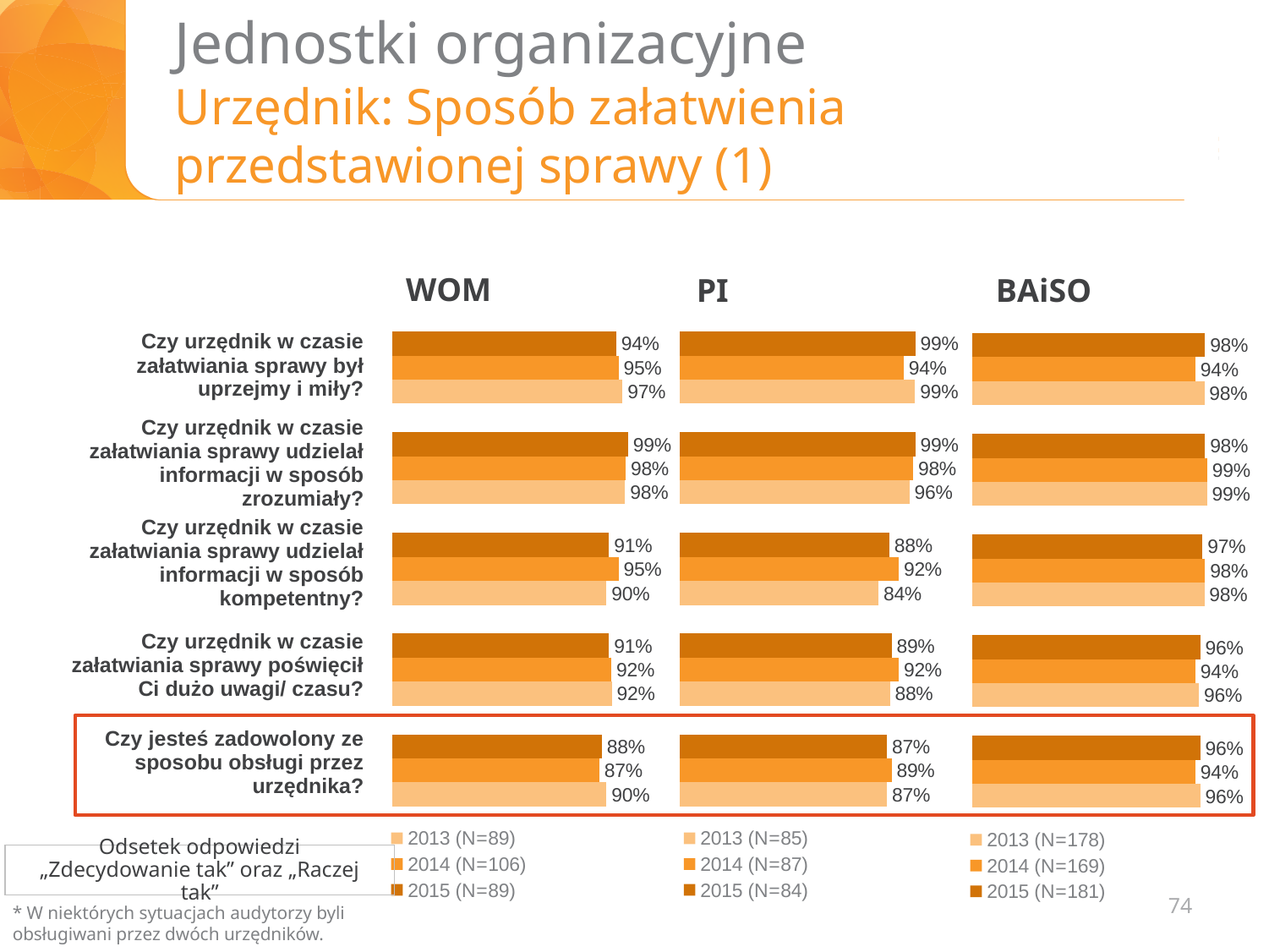
In the PI chart, what is the 2013 value for "Czy urzędnik w czasie załatwiania sprawy udzielał informacji w sposób kompetentny?"? 84% In the PI chart, what is the difference between the 2014 and 2013 values for "Czy urzędnik w czasie załatwiania sprawy udzielał informacji w sposób kompetentny?"? 8 percentage points What type of chart is used for the BAiSO data? Bar chart In the WOM chart, which is larger for "Czy jesteś zadowolony ze sposobu obsługi przez urzędnika?": the 2013 value or the 2015 value? 2013 How many questions (categories) are shown in the WOM chart? 5 According to the legend of the BAiSO chart, what is the sample size (N) for 2015? N=181 In the WOM chart, what is the 2015 value for "Czy jesteś zadowolony ze sposobu obsługi przez urzędnika?"? 88% How many series does the legend of the PI chart list? 3 In the PI chart, which question has the lowest 2013 value? Czy urzędnik w czasie załatwiania sprawy udzielał informacji w sposób kompetentny? In the BAiSO chart, what is the 2014 value for "Czy urzędnik w czasie załatwiania sprawy był uprzejmy i miły?"? 94% In the WOM chart, what is the 2013 value for "Czy urzędnik w czasie załatwiania sprawy był uprzejmy i miły?"? 97%